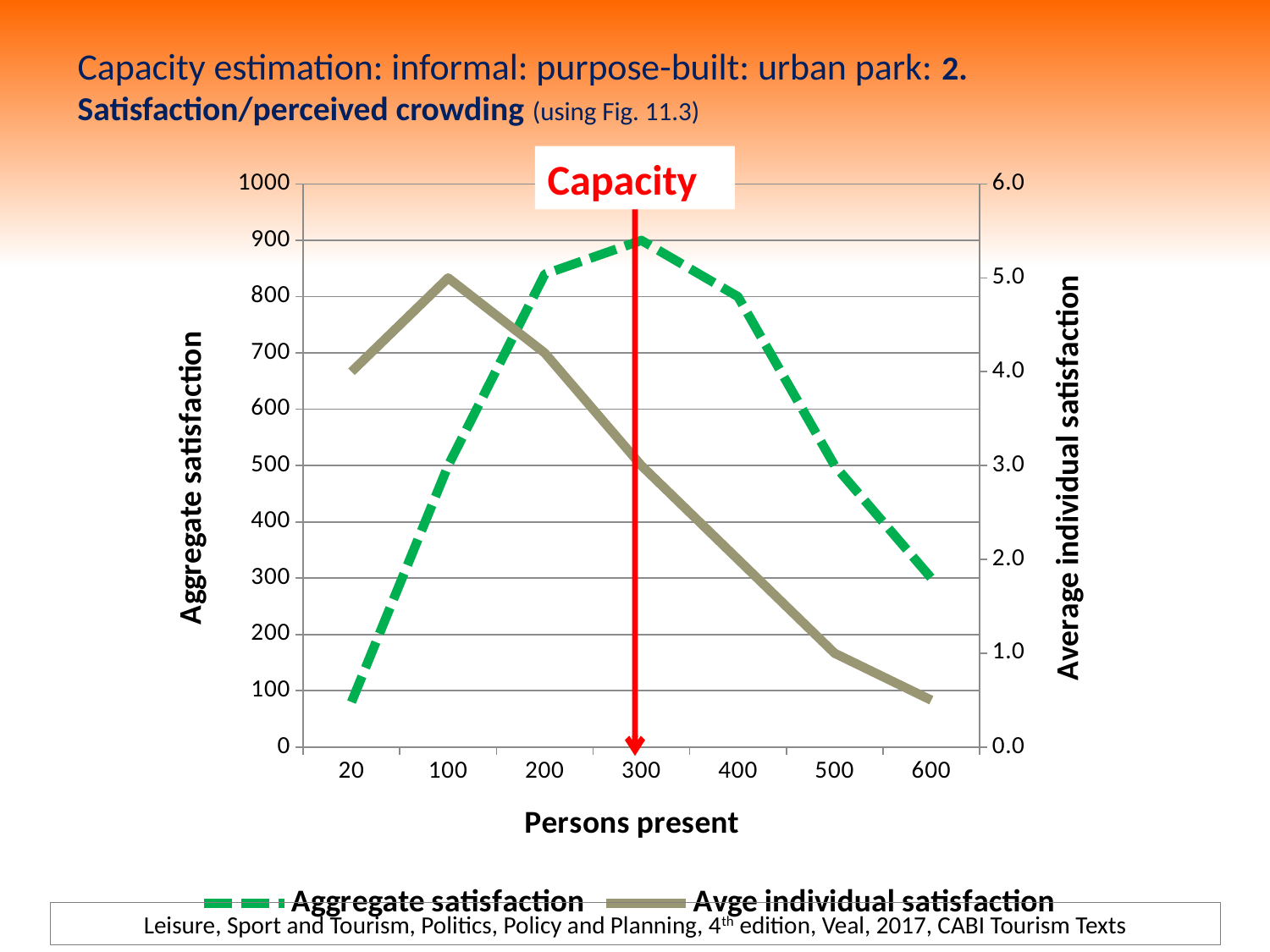
At which number of persons present is Avge individual satisfaction highest? 100 Is the Avge individual satisfaction value at 600 persons present greater or less than 1.0? less At which number of persons present is Aggregate satisfaction highest? 300 At which number of persons present is Avge individual satisfaction lowest? 600 What label is shown on the red vertical arrow in the chart? Capacity What kind of chart is shown on the slide? line chart At which number of persons present is Aggregate satisfaction lowest? 20 How many 'Persons present' values are plotted along the x axis? 7 Does Avge individual satisfaction rise or fall as persons present increases from 100 to 600? fall How many series does the legend list? 2 Is the Aggregate satisfaction value at 20 persons present greater or less than 100? less What is the Aggregate satisfaction value at 300 persons present? 900